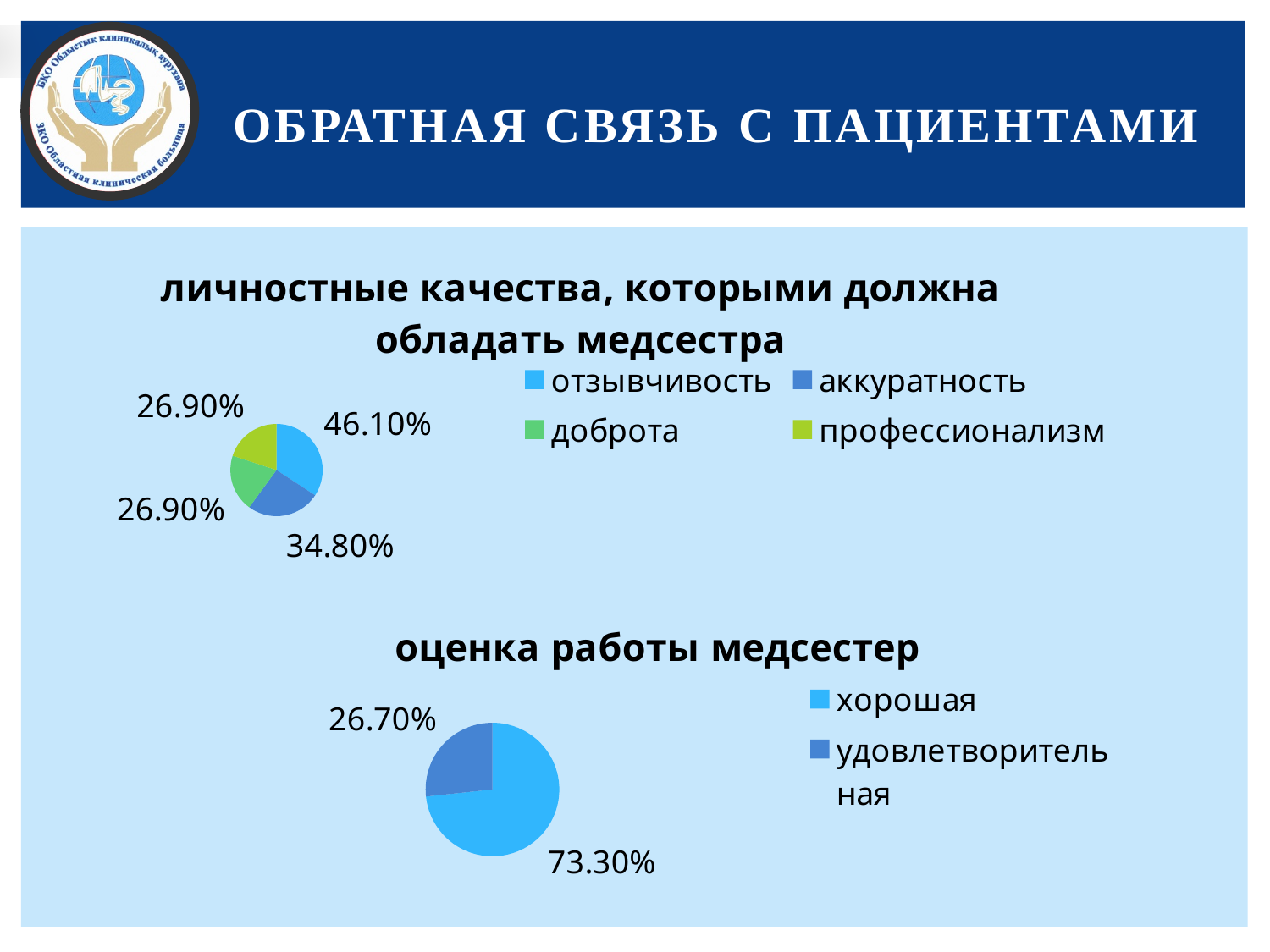
In the chart titled "личностные качества, которыми должна обладать медсестра", what is the difference between the values for отзывчивость and аккуратность? 11.30% In the chart titled "личностные качества, которыми должна обладать медсестра", which is larger, аккуратность or профессионализм? аккуратность In the chart titled "личностные качества, которыми должна обладать медсестра", what is the value for доброта? 26.90% In the chart titled "личностные качества, которыми должна обладать медсестра", what is the value for отзывчивость? 46.10% In the chart titled "личностные качества, которыми должна обладать медсестра", how many categories does the legend list? 4 In the chart titled "оценка работы медсестер", what is the value for удовлетворительная? 26.70% In the chart titled "личностные качества, которыми должна обладать медсестра", which category has the highest value? отзывчивость In the chart titled "оценка работы медсестер", which category has the lowest value? удовлетворительная In the chart titled "личностные качества, которыми должна обладать медсестра", what is the value for аккуратность? 34.80% In the chart titled "оценка работы медсестер", what is the difference between the values for хорошая and удовлетворительная? 46.60% In the chart titled "оценка работы медсестер", what is the value for хорошая? 73.30% What kind of chart is the chart titled "оценка работы медсестер"? pie chart